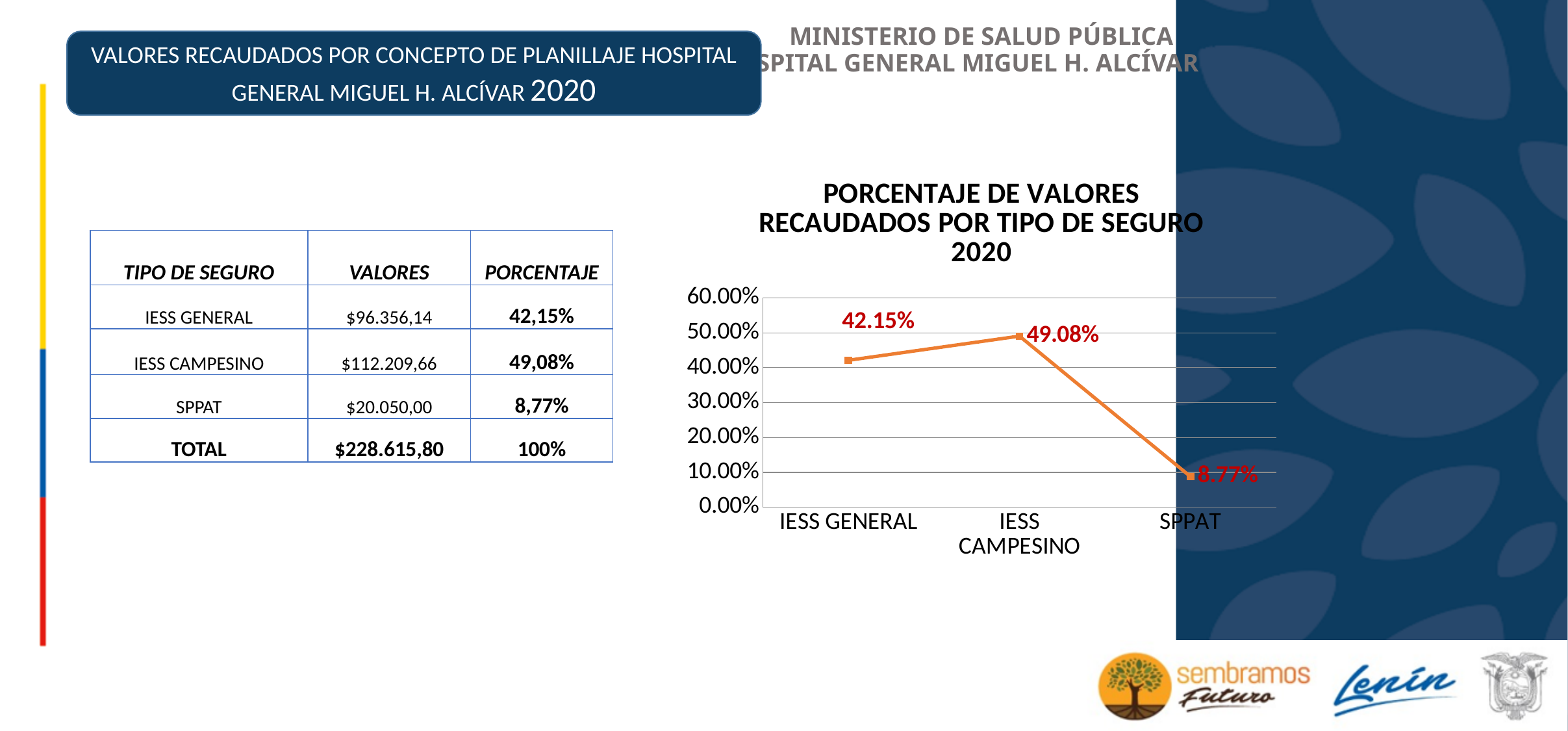
Which is larger, the value for IESS GENERAL or the value for SPPAT? IESS GENERAL Which category has the highest value in the chart? IESS CAMPESINO What is the value for IESS GENERAL in the chart? 42.15% What is the difference between the values for IESS CAMPESINO and IESS GENERAL? 6.93% What is the value for IESS CAMPESINO in the chart? 49.08% Is the value for SPPAT greater or less than 10.00%? less What kind of chart is shown on the slide? line chart Which category has the lowest value in the chart? SPPAT What is the value for SPPAT in the chart? 8.77% What is the difference between the values for IESS GENERAL and SPPAT? 33.38% What is the title of the chart? PORCENTAJE DE VALORES RECAUDADOS POR TIPO DE SEGURO 2020 How many categories are shown on the x axis of the chart? 3